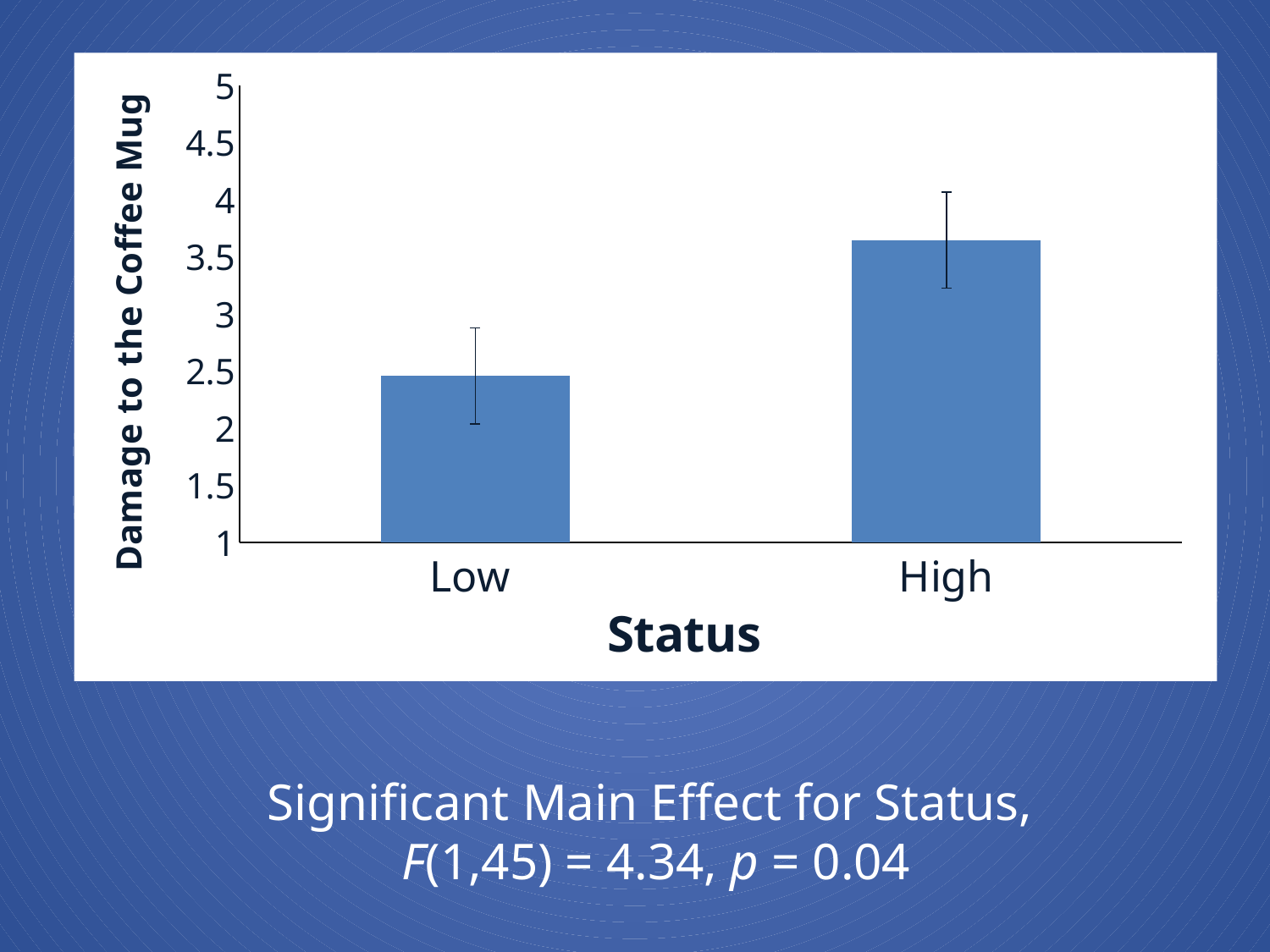
Is the value for High greater or less than 3? greater Which bar is taller, Low or High? High How many bars (categories) are plotted on the chart? 2 What is the title of the horizontal axis? Status Which status category has the highest damage to the coffee mug? High Is the value for Low greater or less than 3? less What kind of chart is shown on the slide? bar chart Is the value for Low greater or less than 2? greater Which status category has the lowest damage to the coffee mug? Low Do the values rise or fall moving from Low to High along the x axis? rise What is the title of the vertical axis? Damage to the Coffee Mug